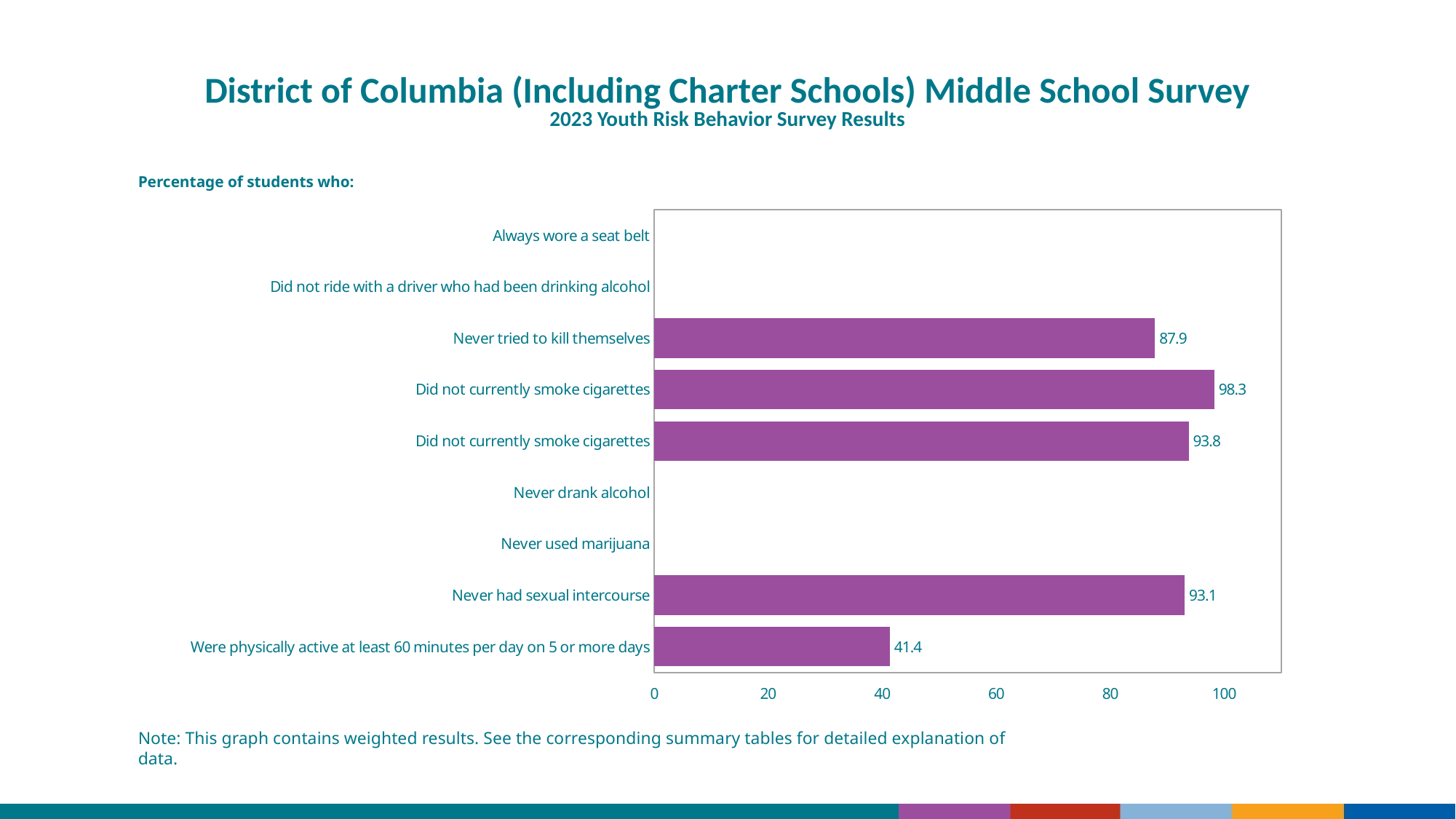
Is the value for "Never had sexual intercourse" greater or less than 80? greater What is the value for "Were physically active at least 60 minutes per day on 5 or more days"? 41.4 What is the value for "Never tried to kill themselves"? 87.9 What is the subtitle shown under the main title of the slide? 2023 Youth Risk Behavior Survey Results What is the difference between the values for "Never tried to kill themselves" and "Were physically active at least 60 minutes per day on 5 or more days"? 46.5 Which is larger: the value for "Never tried to kill themselves" or the value for "Never had sexual intercourse"? Never had sexual intercourse What is the value of the upper of the two bars labelled "Did not currently smoke cigarettes"? 98.3 Which category has the highest value? Did not currently smoke cigarettes What is the value for "Never had sexual intercourse"? 93.1 Which category has the lowest plotted value? Were physically active at least 60 minutes per day on 5 or more days How many categories have a bar plotted in the chart? 5 What kind of chart is shown on the slide? bar chart